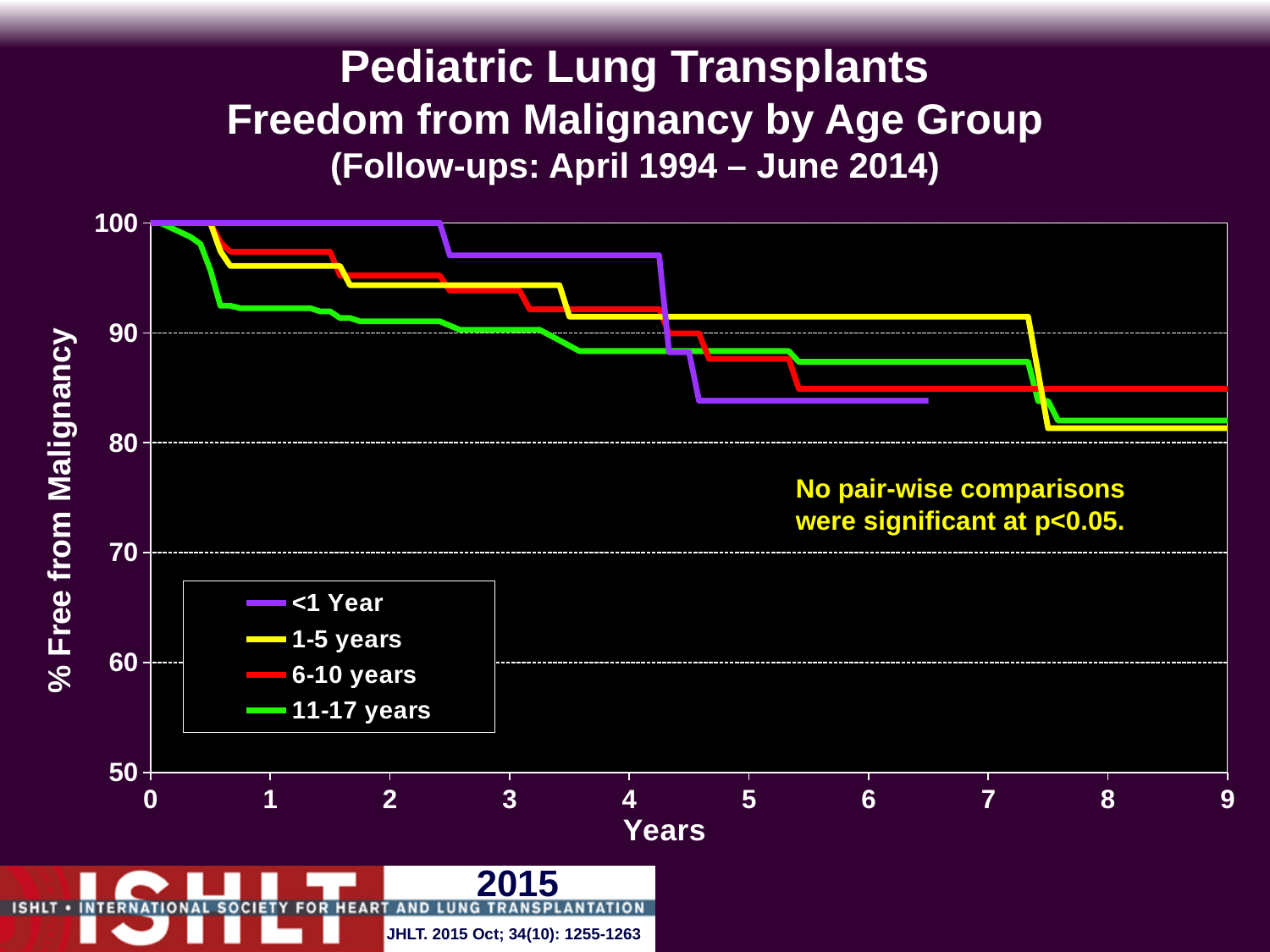
Is the value for the <1 Year group at 5 years greater or less than 90? less At 2 years, which age group has the highest % free from malignancy? <1 Year Which age group does the purple line represent? <1 Year At 6 years, which is higher: the 1-5 years group or the 11-17 years group? 1-5 years Is the value for the 6-10 years group at 8 years greater or less than 90? less Do the values for the 11-17 years group rise or fall as years increase? fall At 2 years, which age group has the lowest % free from malignancy? 11-17 years What kind of chart is shown on the slide? line chart How many series does the legend list? 4 Is the value for the 1-5 years group at 6 years greater or less than 90? greater What is the label of the y axis? % Free from Malignancy